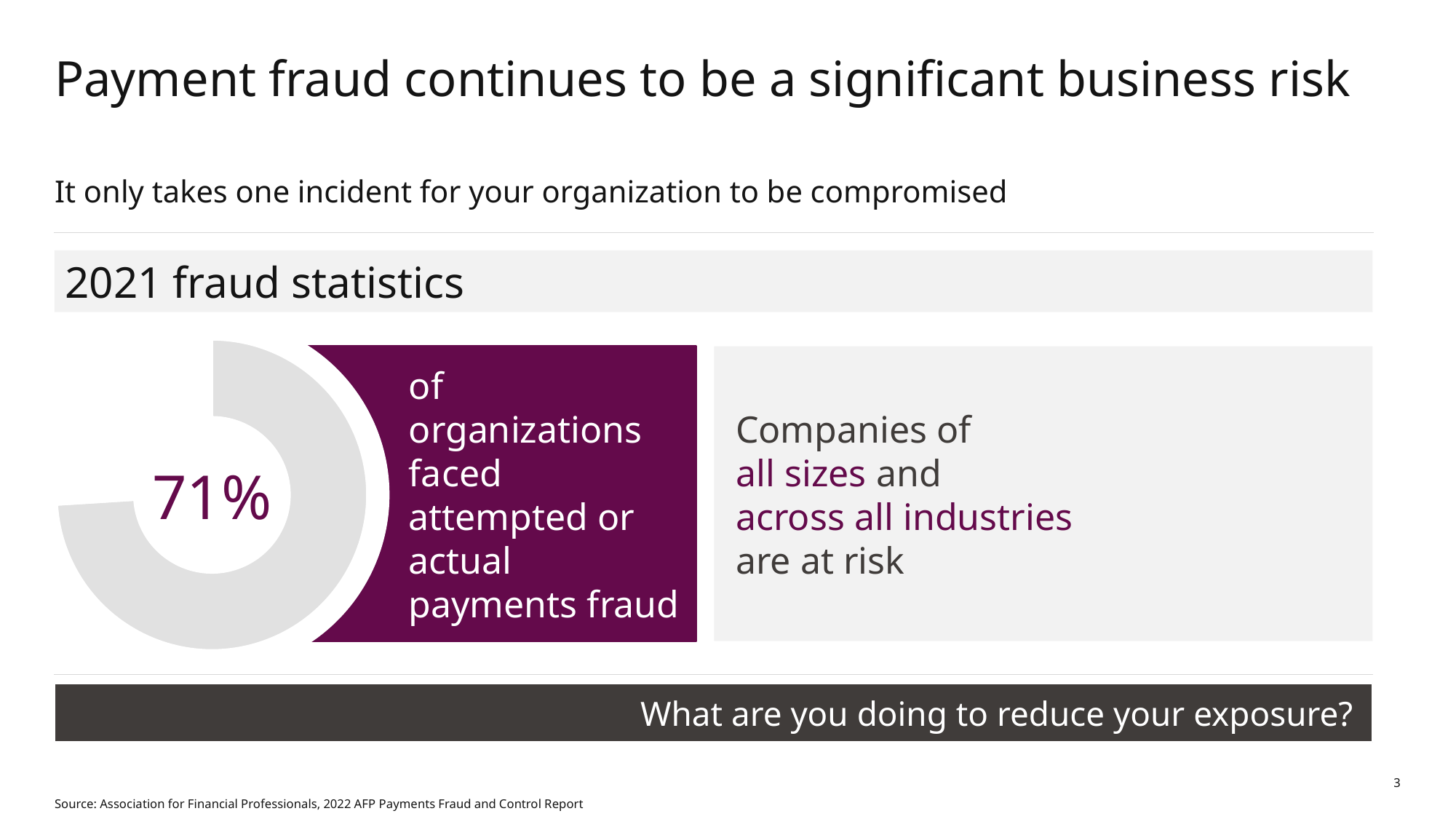
What does the 71% in the donut chart represent? Organizations that faced attempted or actual payments fraud Is the value shown in the donut chart greater or less than 50%? greater What percentage of organizations faced attempted or actual payments fraud according to the donut chart? 71% What is the heading of the section containing the donut chart? 2021 fraud statistics What is the source cited for the fraud statistic shown in the chart? Association for Financial Professionals, 2022 AFP Payments Fraud and Control Report How many data values are displayed in the donut chart? 1 What kind of chart is used to show the 71% statistic? Donut chart What share of the donut chart is filled to represent organizations that faced attempted or actual payments fraud? 71%